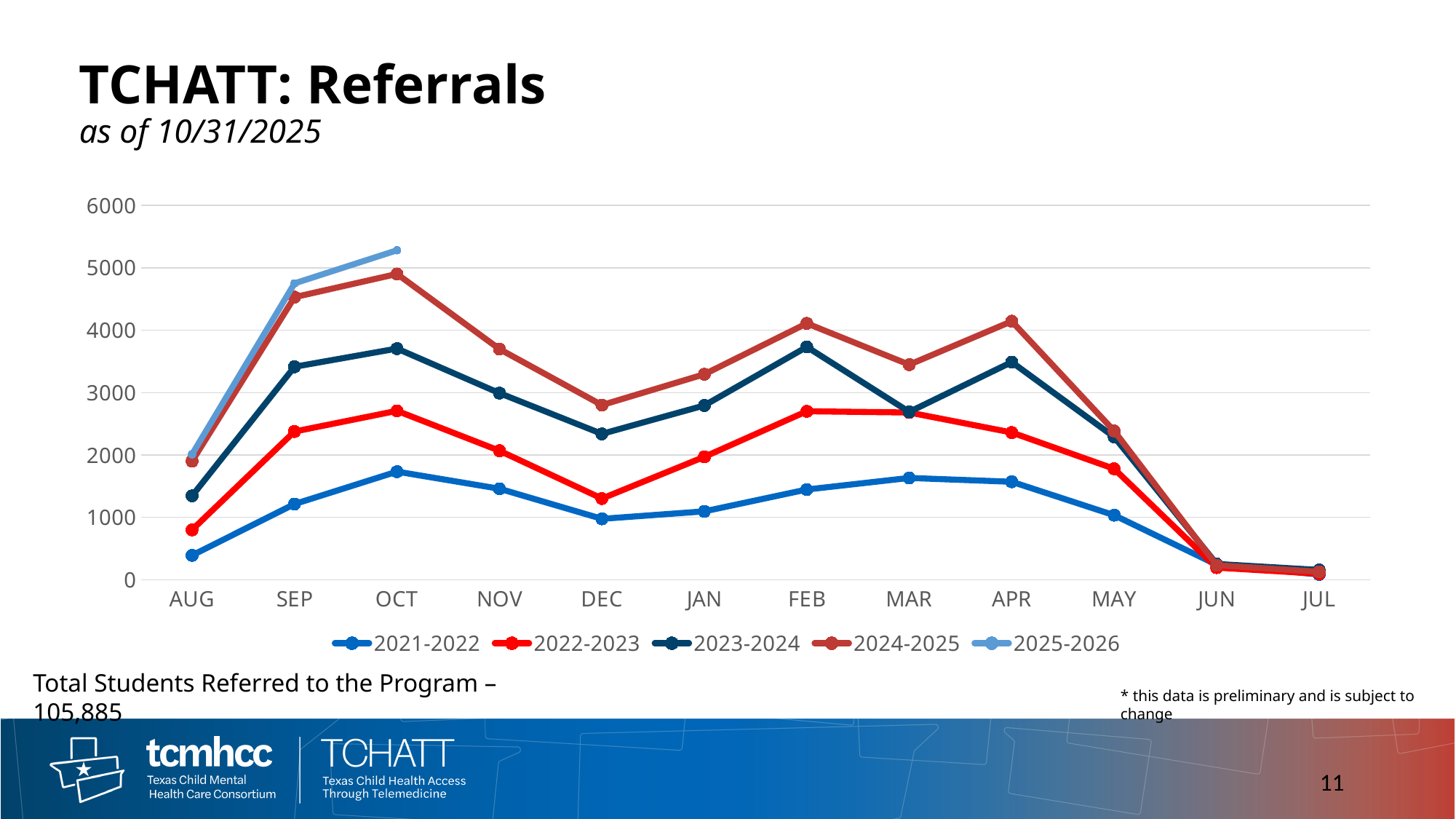
How many series does the legend list? 5 What kind of chart is shown on the slide? line chart Is the value for 2025-2026 in OCT greater or less than 5000? greater In APR, which is larger: the value for 2021-2022 or the value for 2022-2023? 2022-2023 Is the value for 2022-2023 in DEC greater or less than 2000? less How many months are shown along the x axis? 12 Is the value for 2023-2024 in SEP greater or less than 3000? greater In FEB, which is larger: the value for 2023-2024 or the value for 2024-2025? 2024-2025 Which series has the highest value in OCT? 2025-2026 What is the title of the chart on the slide? TCHATT: Referrals Do the values for 2021-2022 rise or fall from AUG to OCT? rise